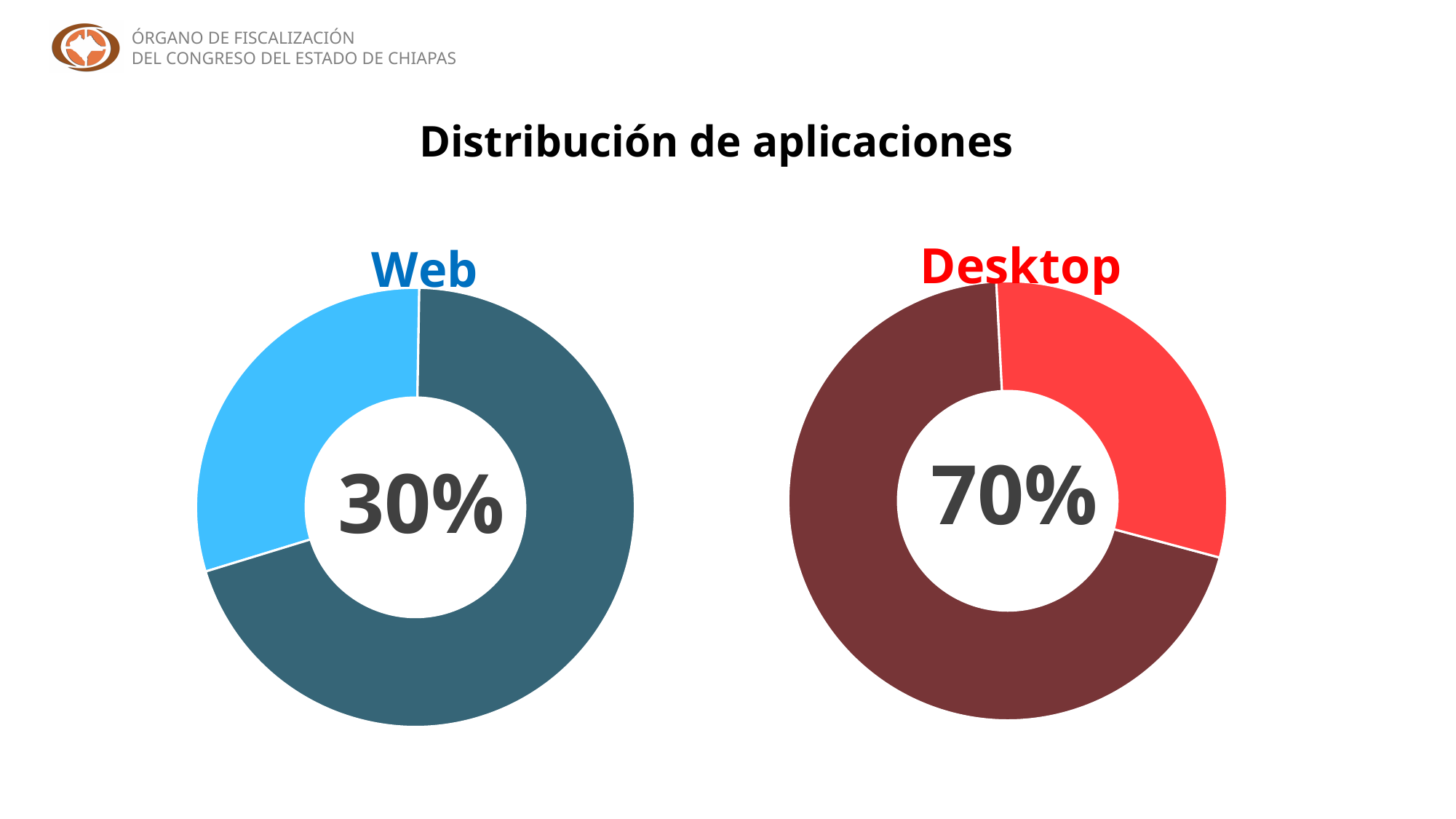
On the Desktop chart, what percentage is shown in the centre of the donut? 70% Which of the two charts shows the larger percentage, Web or Desktop? Desktop What is the difference between the Desktop percentage and the Web percentage? 40% Which of the two charts shows the smaller percentage, Web or Desktop? Web On the Web chart, what percentage is shown in the centre of the donut? 30% How many donut charts are on the slide? 2 On the Desktop chart, is the highlighted share greater or less than 50%? greater What is the total of the Web and Desktop percentages shown on the slide? 100% On the Web chart, is the highlighted share greater or less than 50%? less What is the title of the slide above the two charts? Distribución de aplicaciones What kind of chart is used for the Desktop chart? Donut (pie) chart What kind of chart is used for the Web chart? Donut (pie) chart